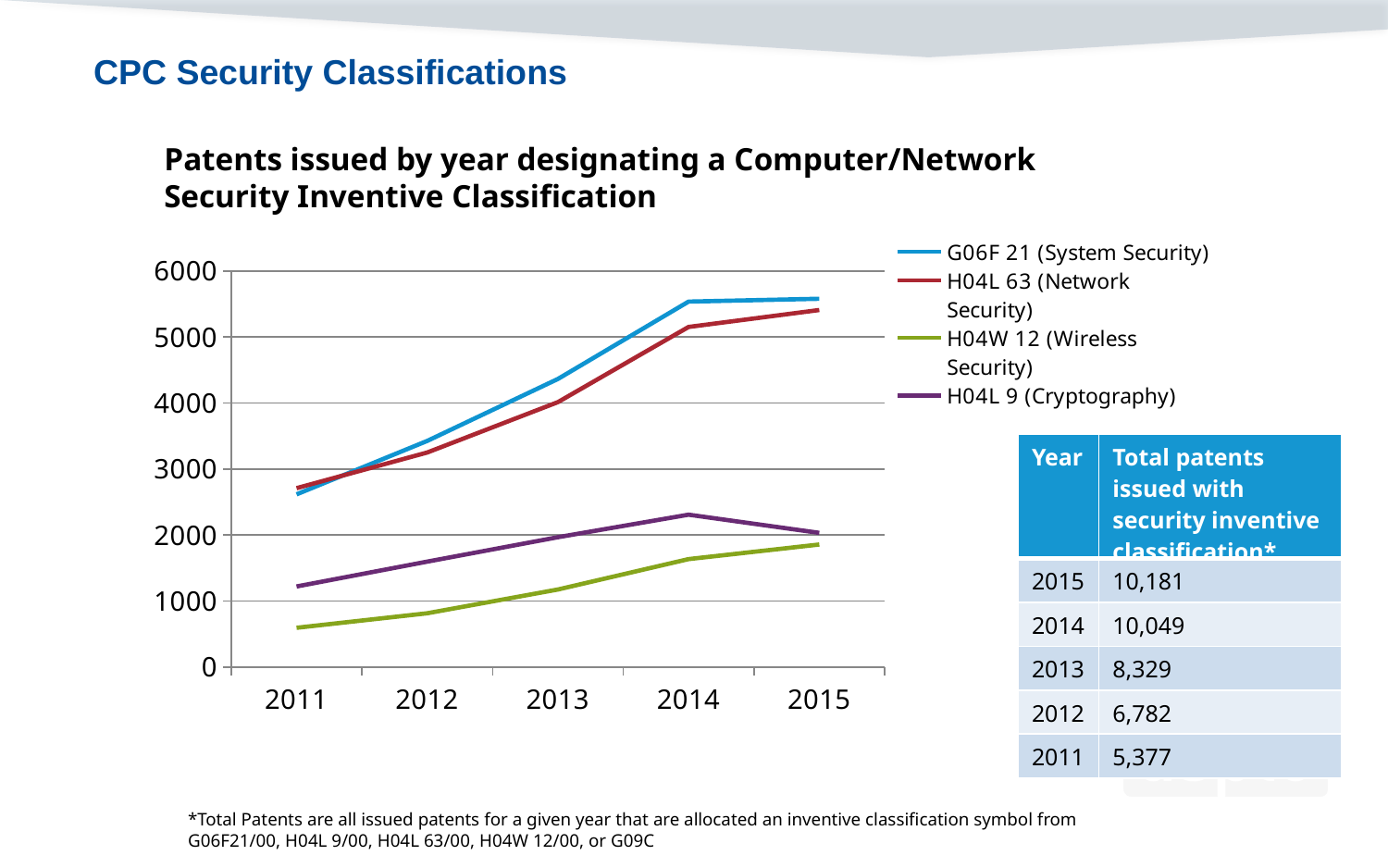
What kind of chart is shown on the slide? Line chart Is the value for H04W 12 (Wireless Security) in 2011 greater or less than 1000? less Which series has the lowest value in 2013? H04W 12 (Wireless Security) Is the value for H04L 63 (Network Security) in 2013 greater or less than 3000? greater What is the title of the chart? Patents issued by year designating a Computer/Network Security Inventive Classification How many years are plotted along the x axis of the chart? 5 In 2015, which is larger: G06F 21 (System Security) or H04W 12 (Wireless Security)? G06F 21 (System Security) Does the H04W 12 (Wireless Security) line rise or fall from 2011 to 2015? rises Is the value for H04L 9 (Cryptography) in 2014 greater or less than 2000? greater Does the H04L 9 (Cryptography) line rise or fall from 2014 to 2015? falls How many series does the chart's legend list? 4